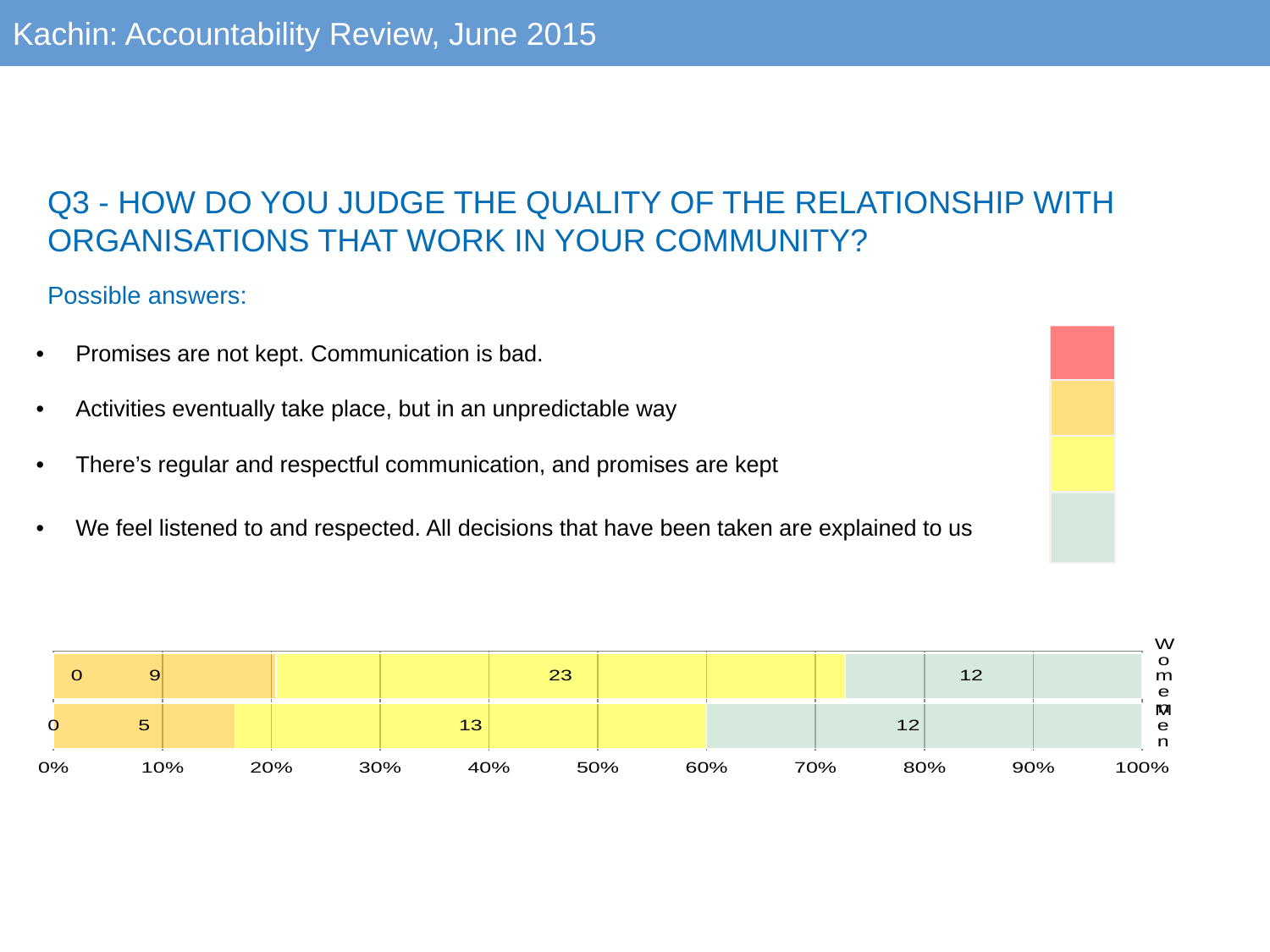
What is the difference between the yellow segment values for Women and Men? 10 Is the share of the Men bar taken by the green segment greater or less than 30%? greater Which bar has the larger orange segment value, Women or Men? Women What is the total of all segments in the Women bar? 44 What kind of chart is shown at the bottom of the slide? Bar chart What is the value of the red segment in the Women bar? 0 Which segment has the highest value in the Women bar? Yellow (23) What is the value of the green segment in the Men bar? 12 What is the total of all segments in the Men bar? 30 How many categories (bars) does the chart show? 2 What is the value of the yellow segment in the Women bar? 23 What is the value of the orange segment in the Men bar? 5